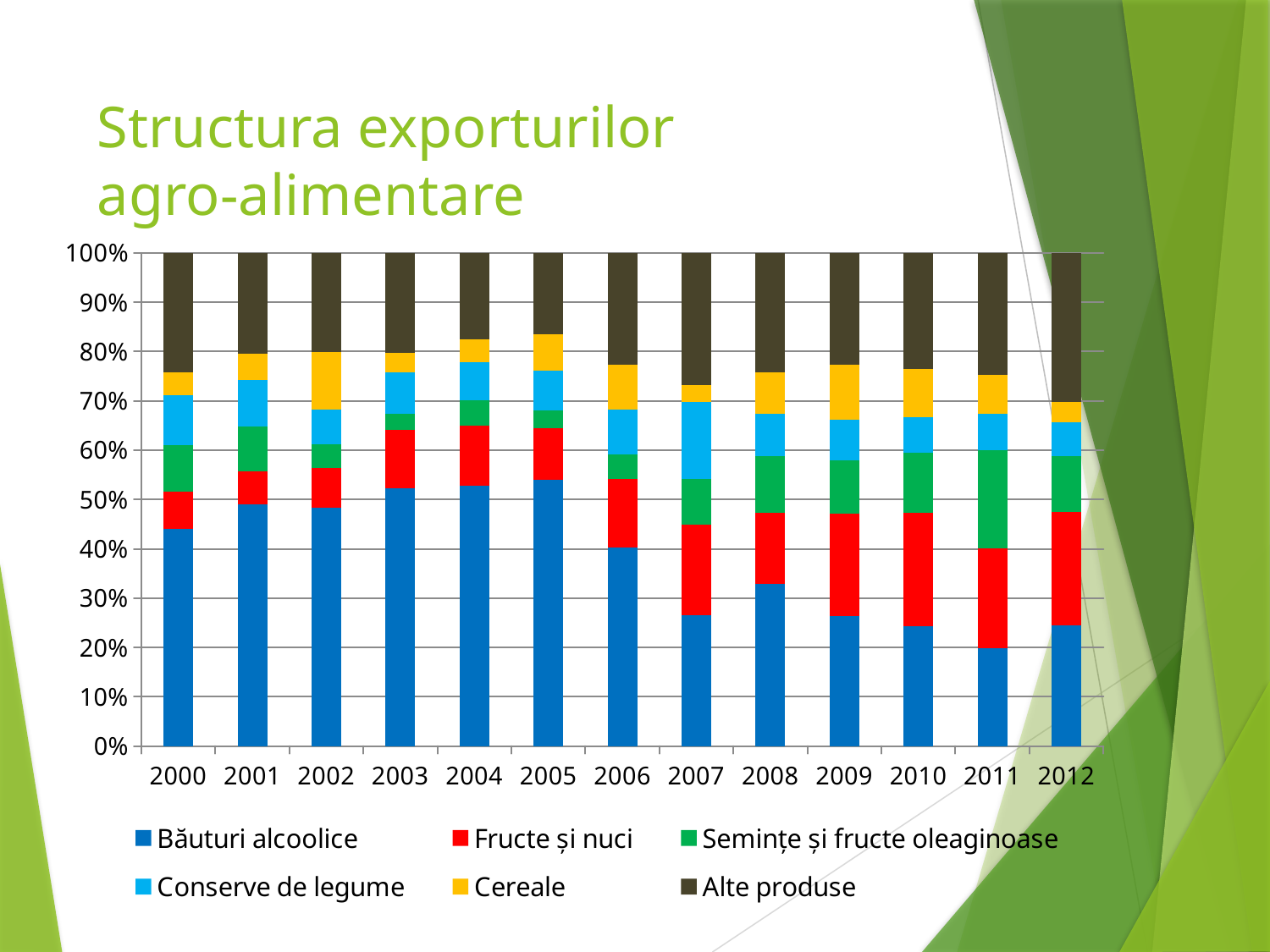
How many years are shown on the x axis of the chart? 13 How many series does the chart's legend list? 6 Does the share of Băuturi alcoolice rise or fall from 2005 to 2011? fall Which year has the larger share of Băuturi alcoolice, 2003 or 2008? 2003 Is the share of Băuturi alcoolice in 2011 greater or less than 30%? less Which series is shown in dark blue at the bottom of each bar? Băuturi alcoolice What is the title of the slide containing the chart? Structura exporturilor agro-alimentare Is the share of Băuturi alcoolice in 2000 greater or less than 40%? greater In which year is the share of Băuturi alcoolice the lowest? 2011 What kind of chart is shown on the slide? Stacked bar chart Is the share of Băuturi alcoolice in 2005 greater or less than 50%? greater